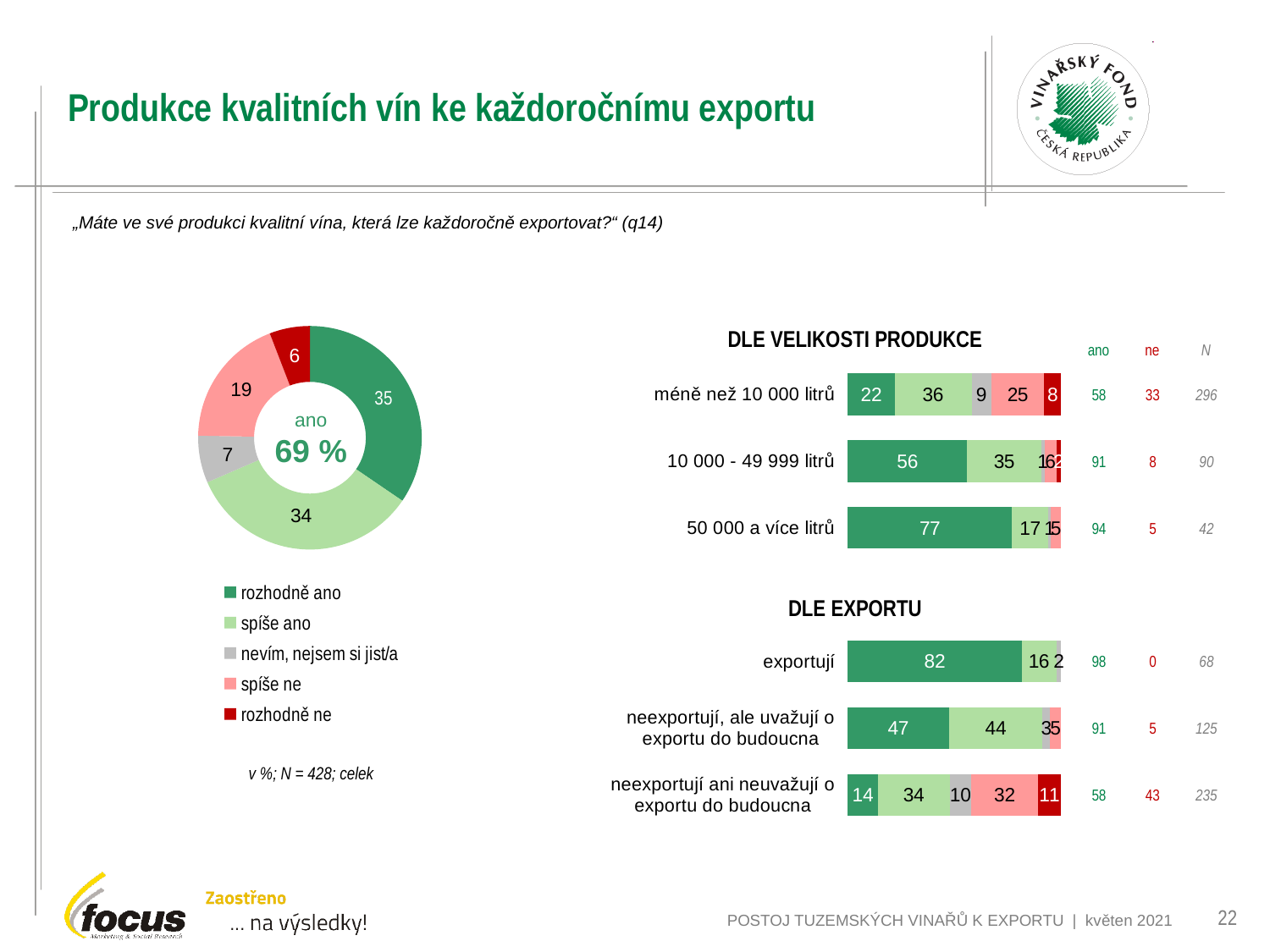
In the donut chart on the left, what percentage is shown in the centre for "ano"? 69 % In the "DLE EXPORTU" chart, what is the "rozhodně ano" value for "exportují"? 82 In the donut chart on the left, what is the value for "rozhodně ano"? 35 In the "DLE VELIKOSTI PRODUKCE" chart, which category has the largest "rozhodně ano" segment? 50 000 a více litrů In the "DLE EXPORTU" chart, what is the "rozhodně ne" value for "neexportují ani neuvažují o exportu do budoucna"? 11 In the "DLE VELIKOSTI PRODUKCE" chart, what is the "rozhodně ano" value for "méně než 10 000 litrů"? 22 In the donut chart on the left, which category has the smallest value? rozhodně ne How many entries does the legend of the donut chart on the left list? 5 In the donut chart on the left, what is the value for "nevím, nejsem si jist/a"? 7 What type of chart is "DLE EXPORTU"? stacked bar chart In the donut chart on the left, what is the difference between the values for "spíše ne" and "rozhodně ne"? 13 In the "DLE VELIKOSTI PRODUKCE" chart, what is the "rozhodně ano" value for "50 000 a více litrů"? 77